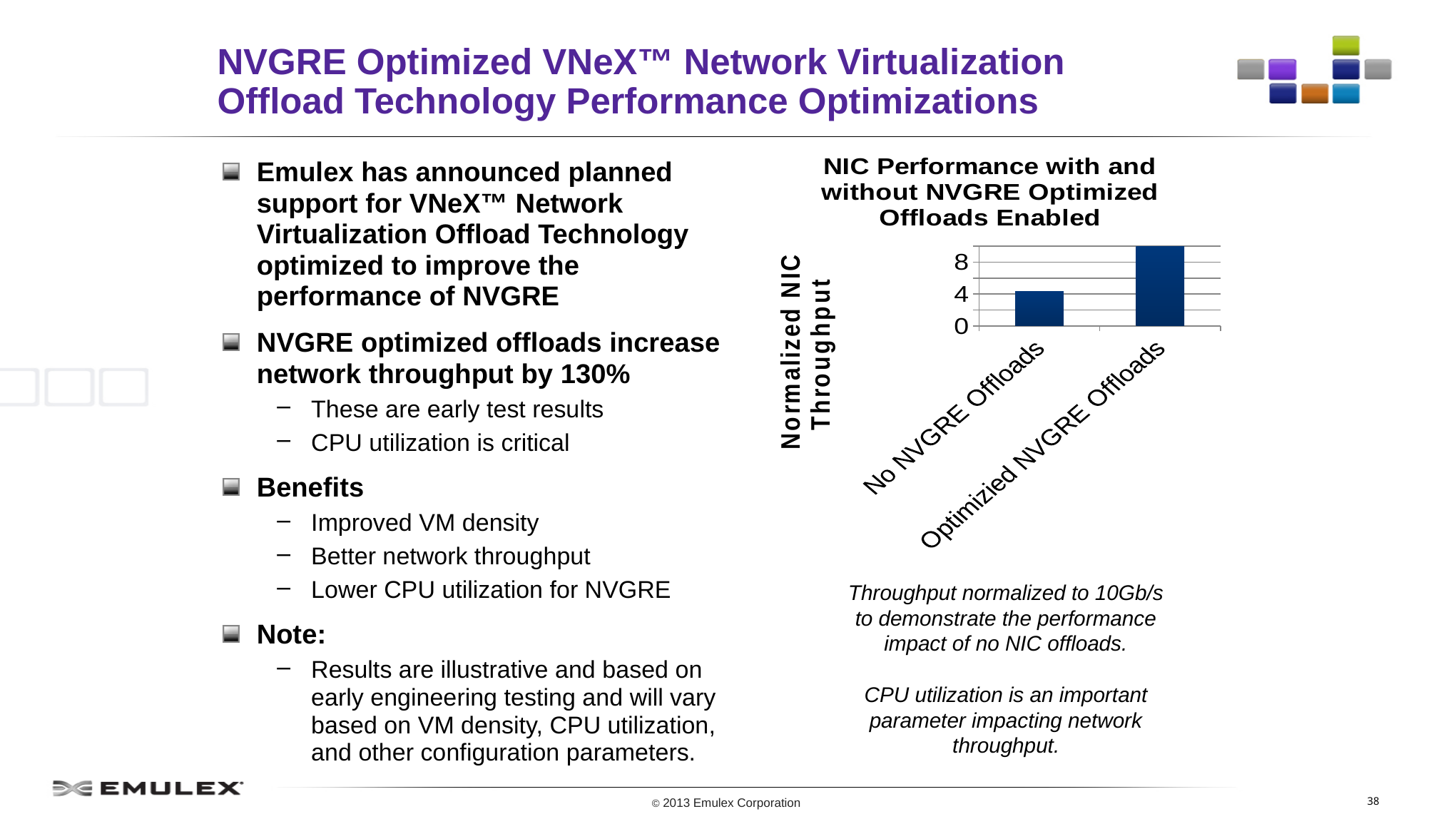
What is the title of the chart? NIC Performance with and without NVGRE Optimized Offloads Enabled Which category has the lowest normalized NIC throughput? No NVGRE Offloads How many bars are plotted in the chart? 2 What kind of chart is shown on the slide? bar chart Which is larger, the value for No NVGRE Offloads or the value for Optimized NVGRE Offloads? Optimizied NVGRE Offloads Is the value for Optimized NVGRE Offloads greater or less than 8? greater Is the value for No NVGRE Offloads greater or less than 8? less What is the label on the vertical axis of the chart? Normalized NIC Throughput Which category has the highest normalized NIC throughput? Optimizied NVGRE Offloads